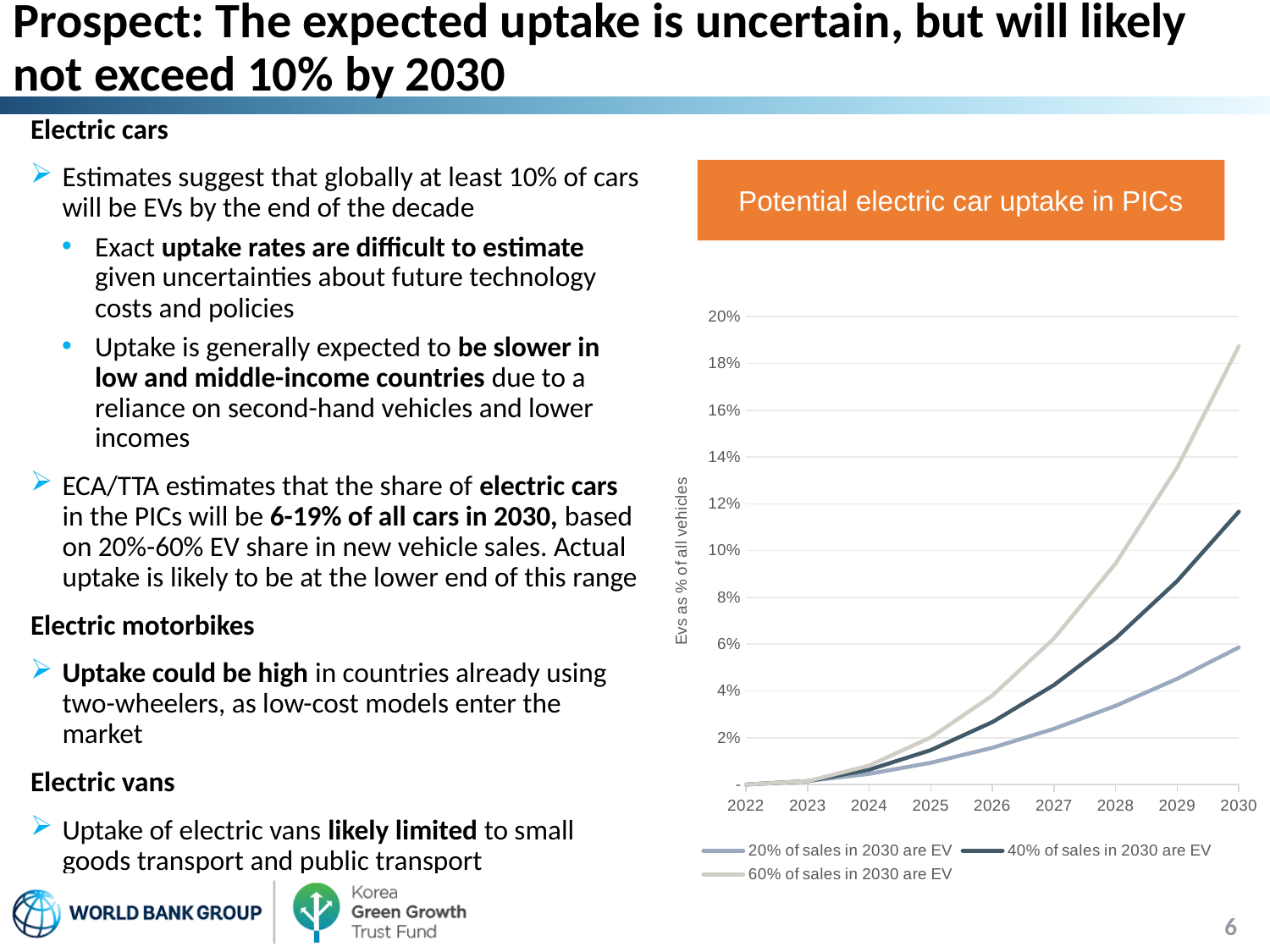
What kind of chart is shown on the slide? line chart Do the values in the chart rise or fall from 2022 to 2030? rise Is the 2030 value for '40% of sales in 2030 are EV' greater or less than 10%? greater Which series has the lowest value in 2030? 20% of sales in 2030 are EV In 2030, which is larger: the value for '40% of sales in 2030 are EV' or '20% of sales in 2030 are EV'? 40% of sales in 2030 are EV Which series has the highest value in 2030? 60% of sales in 2030 are EV Is the 2030 value for '60% of sales in 2030 are EV' greater or less than 16%? greater How many series does the legend of the chart list? 3 Is the 2030 value for '20% of sales in 2030 are EV' greater or less than 8%? less What is the title of the chart? Potential electric car uptake in PICs How many years are shown along the x axis of the chart? 9 What is the label on the y axis of the chart? Evs as % of all vehicles